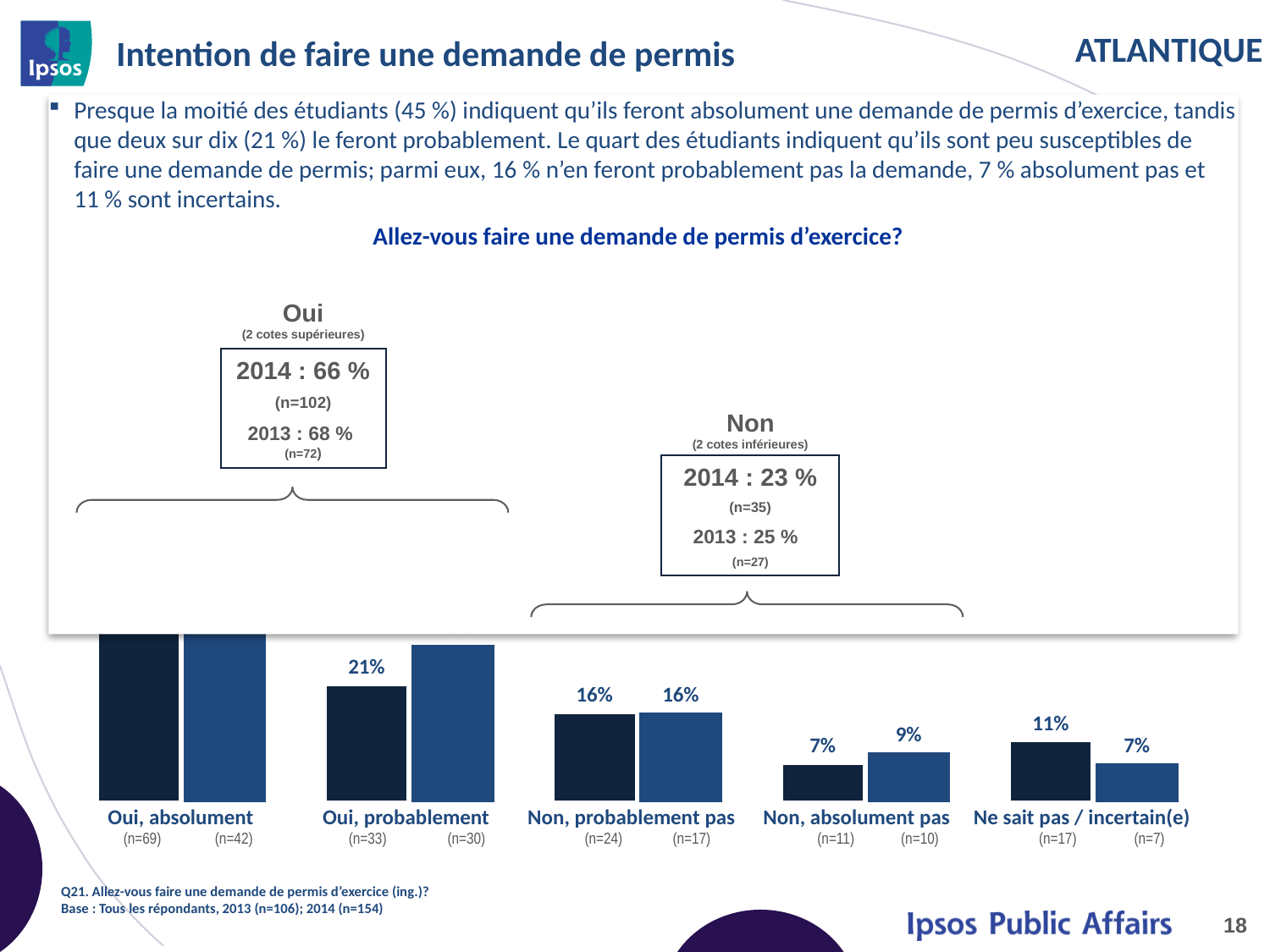
For "Non, absolument pas", which bar is larger, the dark navy bar or the lighter blue bar? the lighter blue bar What is the value of the lighter blue bar for "Non, absolument pas"? 9% What is the value of the lighter blue bar for "Ne sait pas / incertain(e)"? 7% What is the value of the dark navy bar for "Ne sait pas / incertain(e)"? 11% For "Ne sait pas / incertain(e)", what is the difference between the dark navy bar and the lighter blue bar? 4 percentage points How many response categories are shown along the x axis of the chart? 5 For "Ne sait pas / incertain(e)", which bar is larger, the dark navy bar or the lighter blue bar? the dark navy bar What kind of chart is shown on the slide? bar chart What is the value of the dark navy bar for "Non, probablement pas"? 16% What is the value of the dark navy bar for "Oui, probablement"? 21% What is the title of the chart? Allez-vous faire une demande de permis d'exercice? Which response category has the tallest bars in the chart? Oui, absolument